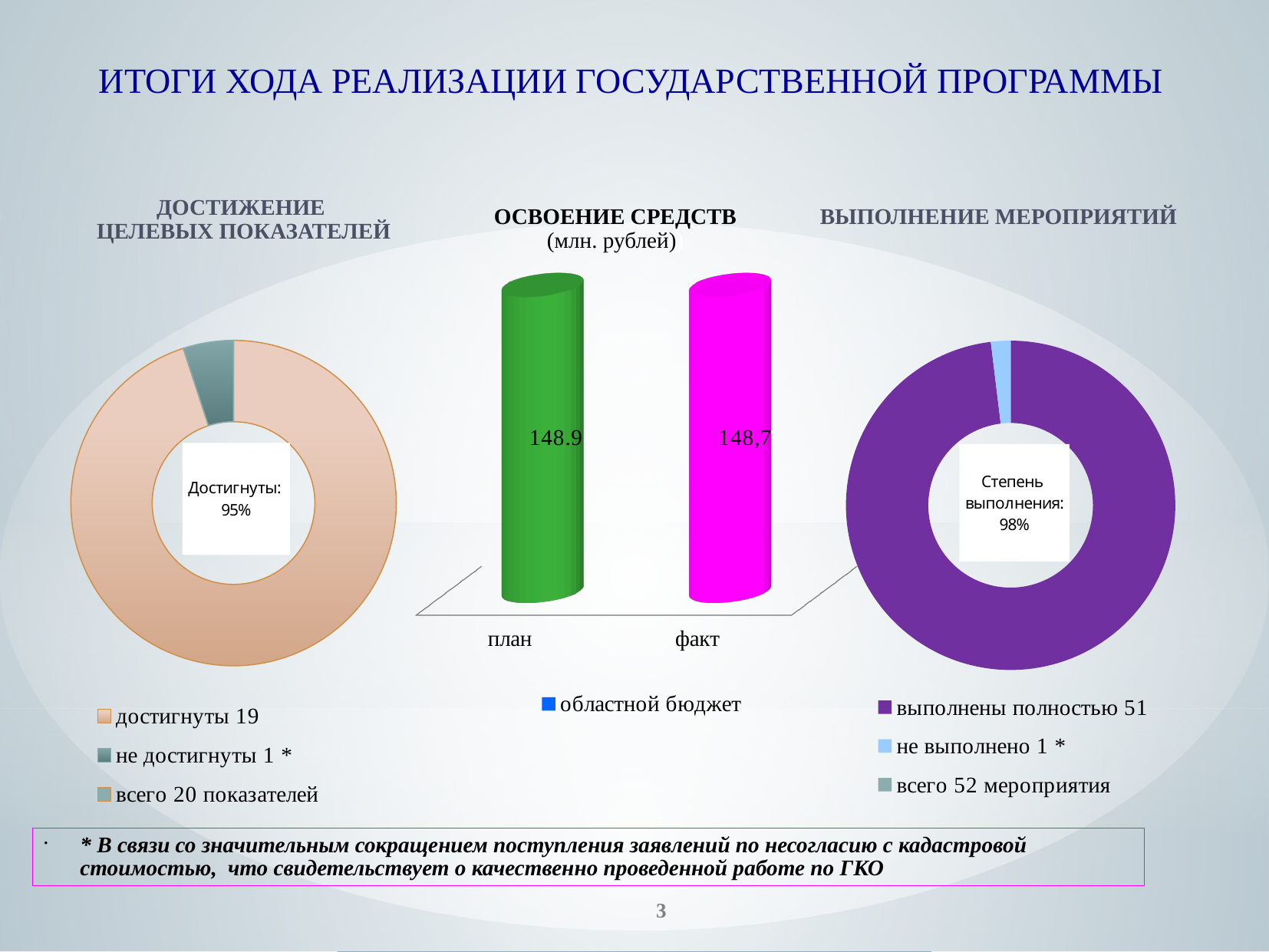
In the ДОСТИЖЕНИЕ ЦЕЛЕВЫХ ПОКАЗАТЕЛЕЙ chart, what share of indicators is shown as achieved (Достигнуты)? 95% In the ОСВОЕНИЕ СРЕДСТВ chart, which is larger, план or факт? план In the ОСВОЕНИЕ СРЕДСТВ chart, what is the value for факт? 148,7 In the ДОСТИЖЕНИЕ ЦЕЛЕВЫХ ПОКАЗАТЕЛЕЙ chart, how many indicators are listed as достигнуты? 19 In the ВЫПОЛНЕНИЕ МЕРОПРИЯТИЙ chart, how many activities are listed as выполнены полностью? 51 How many bars are shown in the ОСВОЕНИЕ СРЕДСТВ chart? 2 What unit is given in the title of the ОСВОЕНИЕ СРЕДСТВ chart? млн. рублей What type of chart is the middle chart titled ОСВОЕНИЕ СРЕДСТВ? bar chart In the ВЫПОЛНЕНИЕ МЕРОПРИЯТИЙ chart, what is the Степень выполнения shown in the centre? 98% In the ОСВОЕНИЕ СРЕДСТВ chart, what is the value for план? 148.9 In the ВЫПОЛНЕНИЕ МЕРОПРИЯТИЙ chart, which category is the largest slice? выполнены полностью What type of chart is the left chart titled ДОСТИЖЕНИЕ ЦЕЛЕВЫХ ПОКАЗАТЕЛЕЙ? doughnut chart